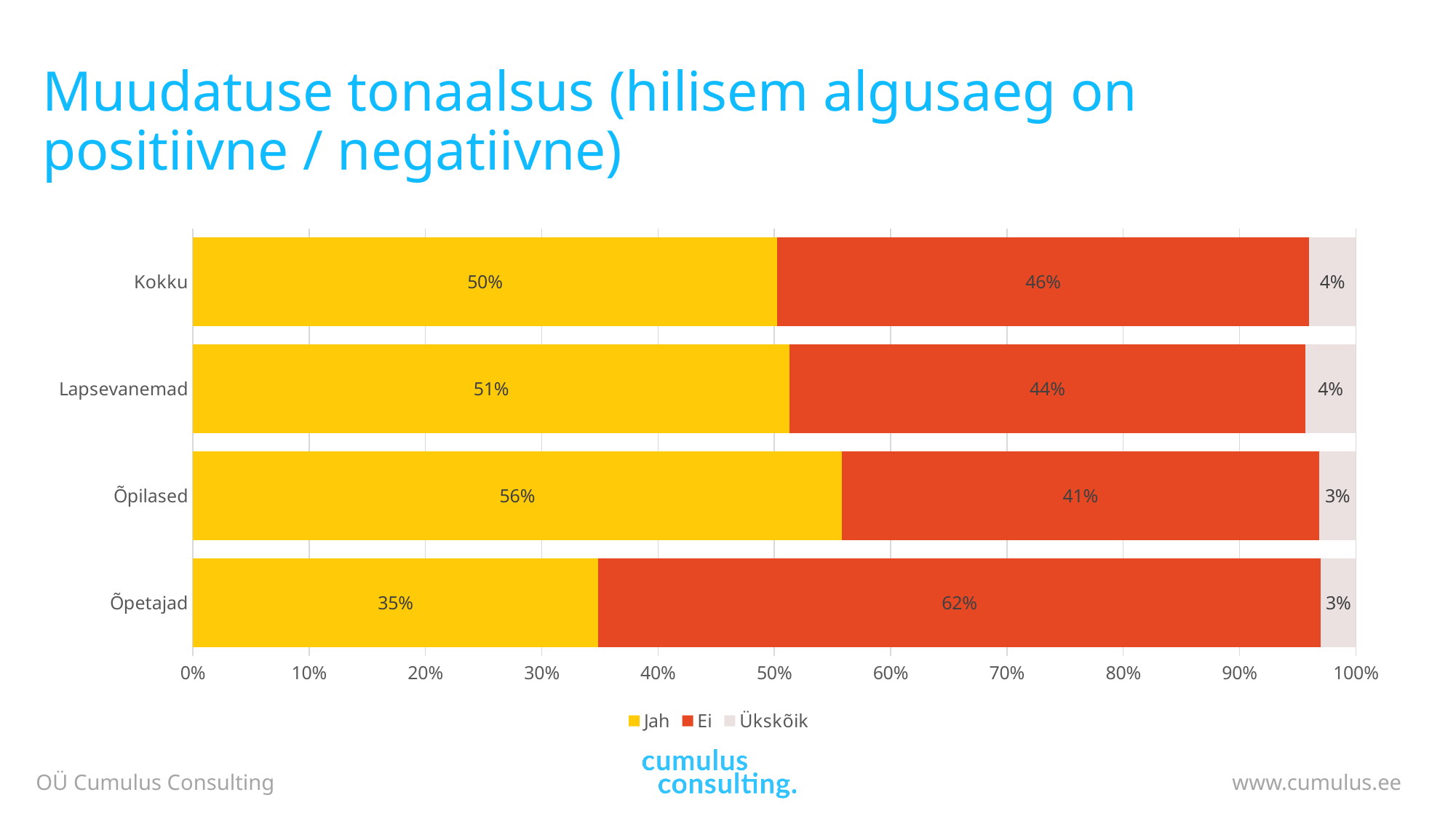
Which category has the highest 'Ei' value? Õpetajad Which category has the lowest 'Jah' value? Õpetajad What is the 'Jah' value for Õpetajad? 35% What is the 'Ükskõik' value for Kokku? 4% Is the 'Jah' value for Õpilased larger than the 'Jah' value for Lapsevanemad? Yes What kind of chart is shown on the slide? Stacked bar chart How many categories are shown on the y axis? 4 What is the total of the stacked bar for Õpetajad? 100% Which category has the highest 'Jah' value? Õpilased How many series does the legend list? 3 What is the 'Ei' value for Lapsevanemad? 44% What is the difference between the 'Ei' value for Õpetajad and the 'Ei' value for Õpilased? 21%